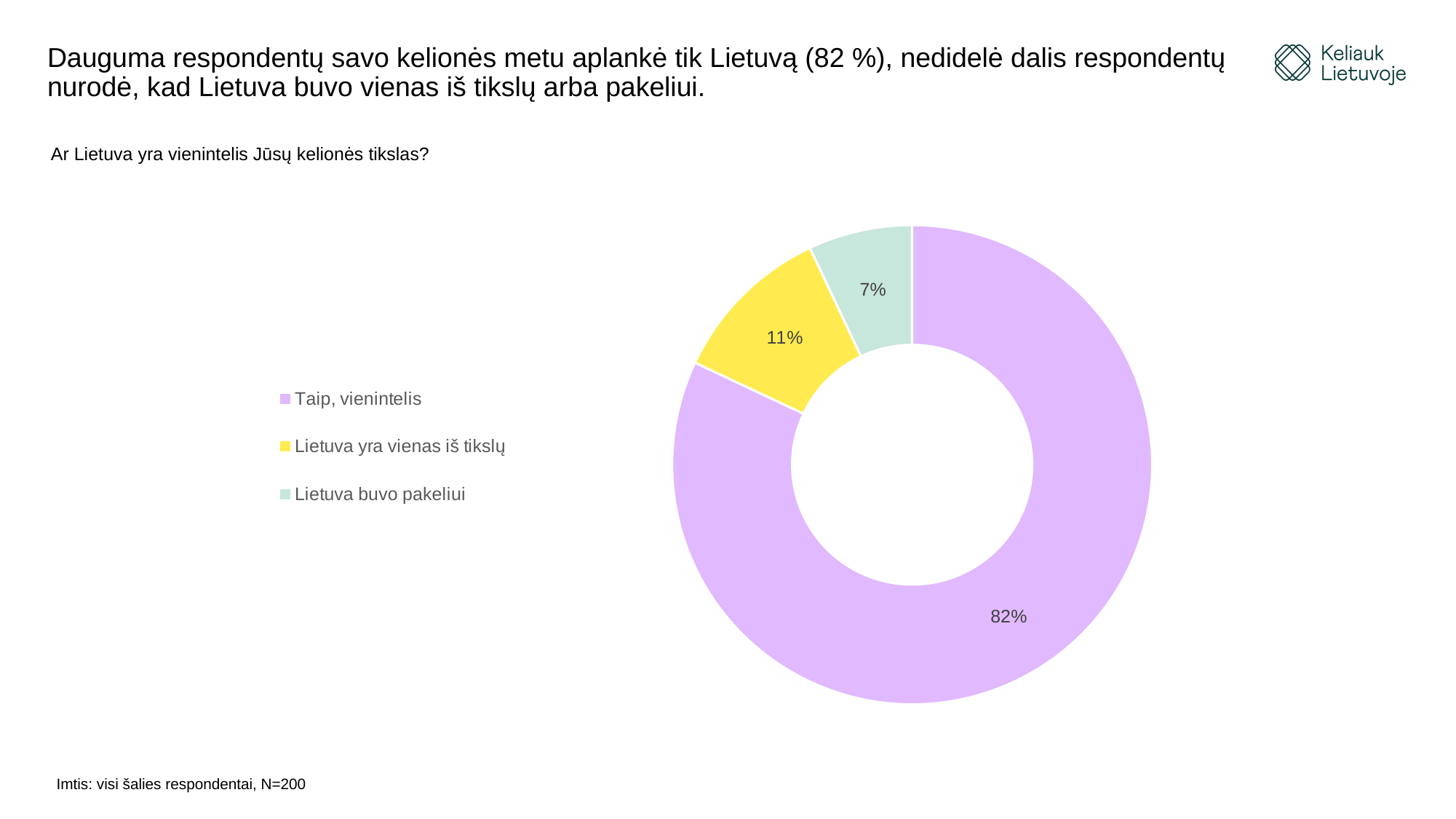
What is the difference in percentage points between "Taip, vienintelis" and "Lietuva yra vienas iš tikslų"? 71 What share of respondents answered "Taip, vienintelis"? 82% What colour is the slice for "Lietuva yra vienas iš tikslų"? Yellow What is the difference in percentage points between "Lietuva yra vienas iš tikslų" and "Lietuva buvo pakeliui"? 4 What question does the chart answer, according to the text above it? Ar Lietuva yra vienintelis Jūsų kelionės tikslas? How many categories does the chart show? 3 Which answer category has the largest share? Taip, vienintelis What share of respondents answered "Lietuva buvo pakeliui"? 7% Which answer category has the smallest share? Lietuva buvo pakeliui What kind of chart is shown on the slide? Pie chart (doughnut) Which is larger: the share for "Lietuva yra vienas iš tikslų" or for "Lietuva buvo pakeliui"? Lietuva yra vienas iš tikslų What share of respondents answered "Lietuva yra vienas iš tikslų"? 11%